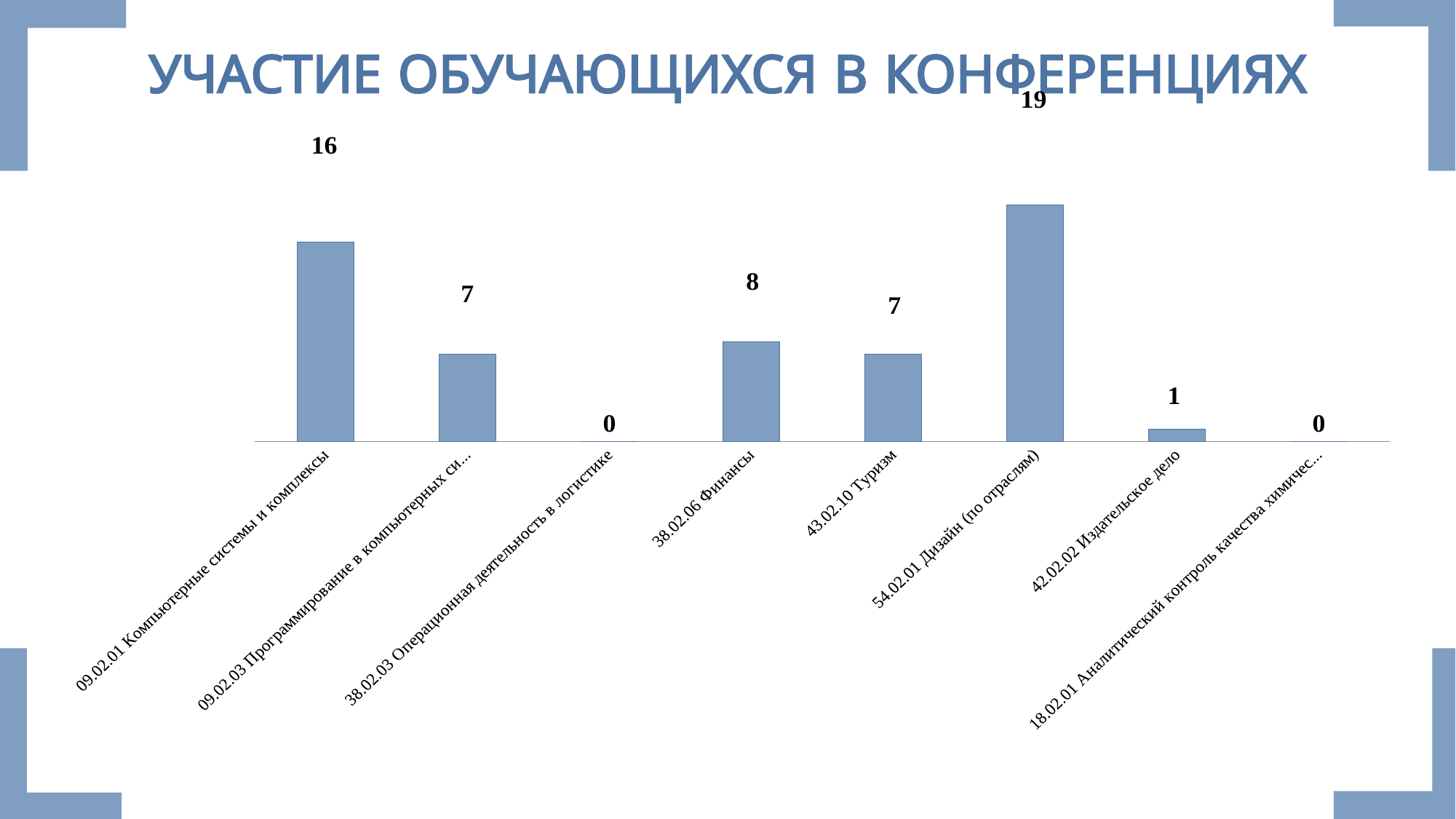
What is the value for 42.02.02 Издательское дело? 1 How many categories are shown on the chart? 8 What is the value for 43.02.10 Туризм? 7 What is the difference between the values for 54.02.01 Дизайн (по отраслям) and 09.02.01 Компьютерные системы и комплексы? 3 What is the value for 38.02.06 Финансы? 8 How many categories have a value of 0? 2 What is the title of the slide? УЧАСТИЕ ОБУЧАЮЩИХСЯ В КОНФЕРЕНЦИЯХ What is the value for 09.02.01 Компьютерные системы и комплексы? 16 What is the difference between the values for 38.02.06 Финансы and 43.02.10 Туризм? 1 Which category has the highest value? 54.02.01 Дизайн (по отраслям) Which is larger, the value for 09.02.01 Компьютерные системы и комплексы or the value for 38.02.06 Финансы? 09.02.01 Компьютерные системы и комплексы What kind of chart is shown on the slide? Bar chart